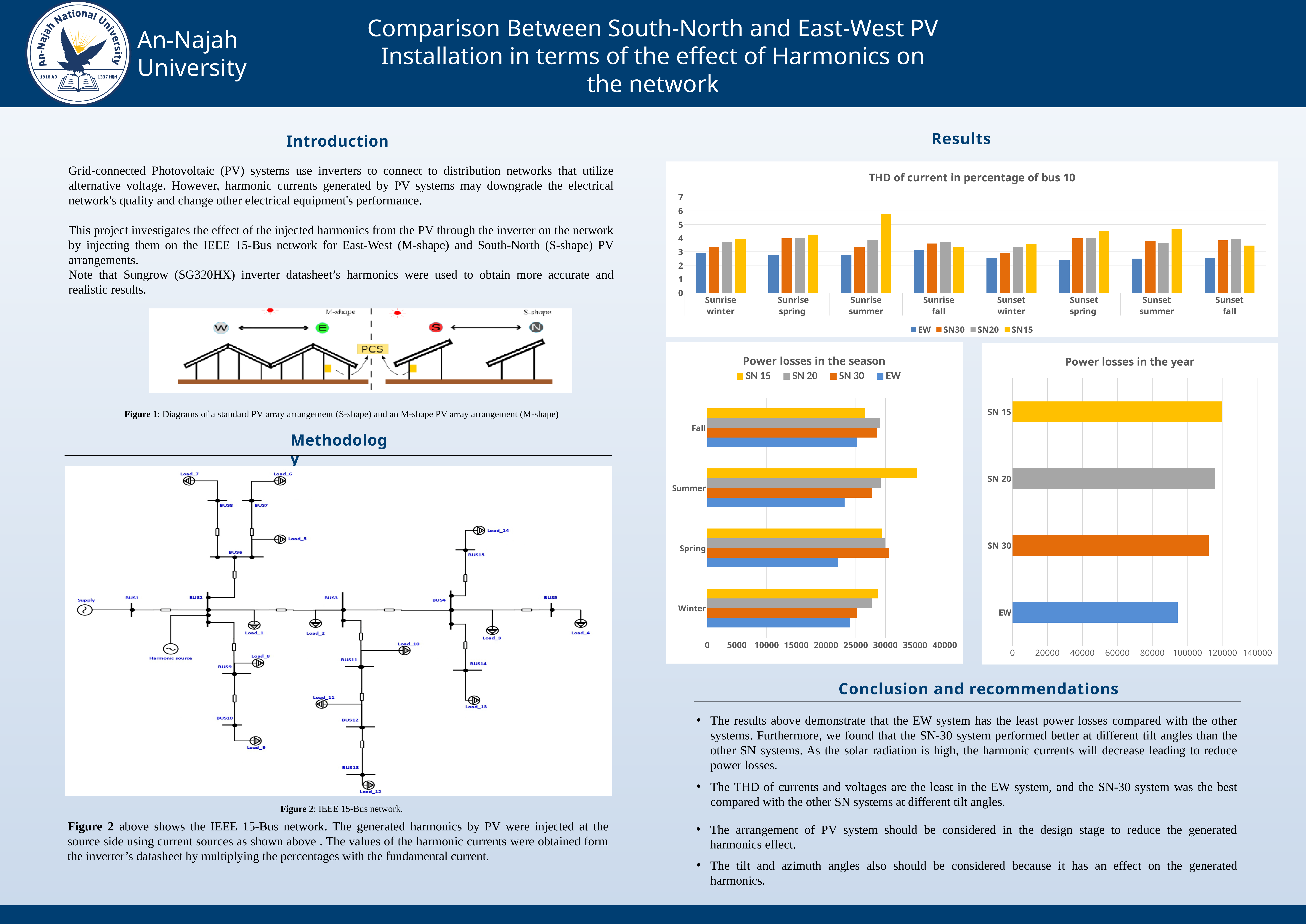
What kind of chart is 'THD of current in percentage of bus 10'? bar chart How many series does the legend of 'THD of current in percentage of bus 10' list? 4 In 'THD of current in percentage of bus 10', which is larger for Sunrise summer: the EW value or the SN15 value? SN15 In 'THD of current in percentage of bus 10', which category has the highest SN15 value? Sunrise summer In 'Power losses in the season', is the SN 15 value for Summer greater or less than 30000? greater In 'Power losses in the year', which is larger: SN 15 or EW? SN 15 In 'THD of current in percentage of bus 10', is the SN15 value for Sunrise summer greater or less than 5? greater In 'Power losses in the year', is the value for EW greater or less than 100000? less In 'Power losses in the year', which category has the lowest value? EW How many series does the legend of 'Power losses in the season' list? 4 How many categories are shown on the x axis of 'THD of current in percentage of bus 10'? 8